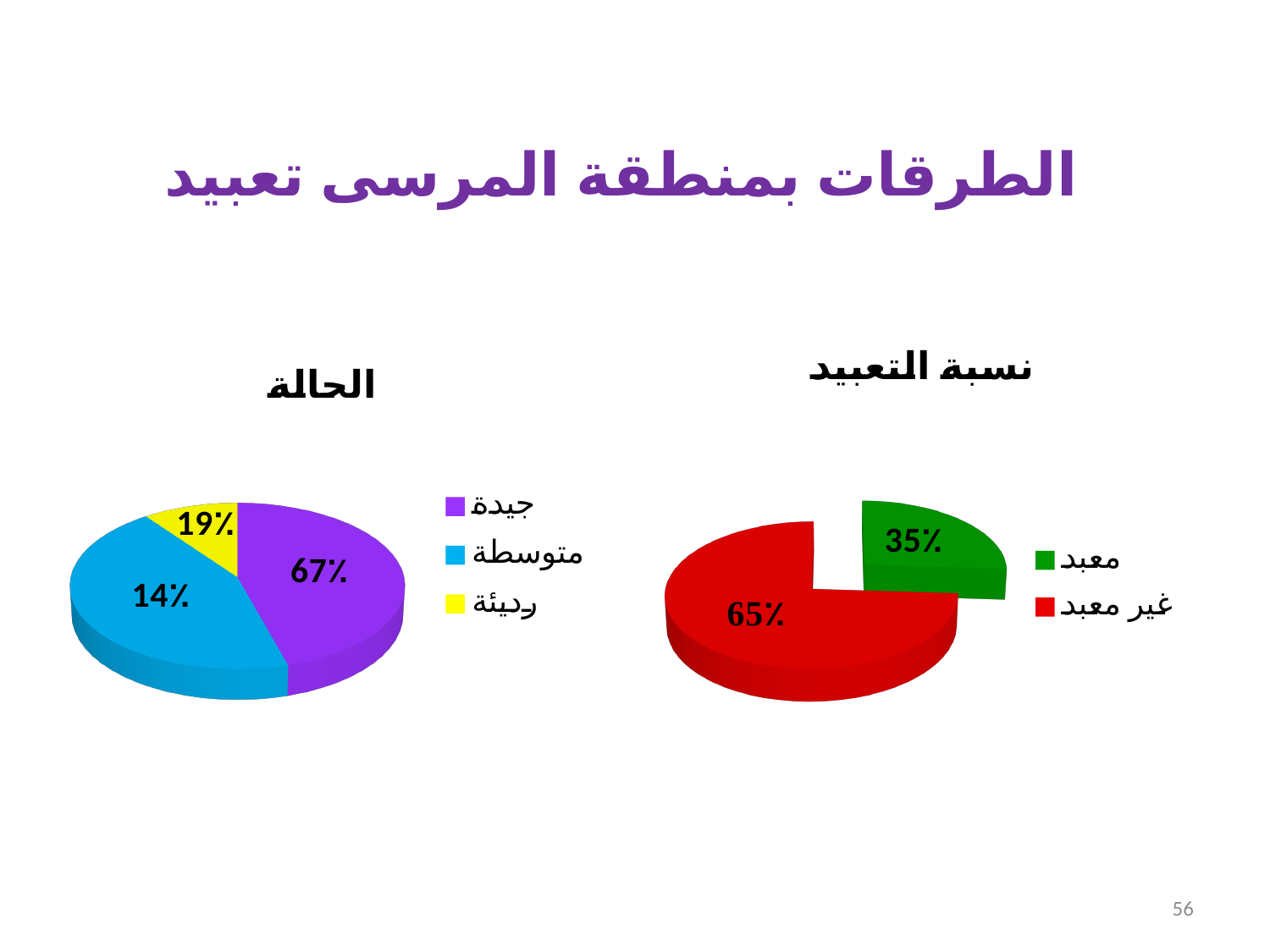
What type of chart is the chart titled "الحالة" (left)? Pie chart In the chart titled "نسبة التعبيد" (right), what percentage is shown for "غير معبد"? 65% In the chart titled "الحالة" (left), what colour represents "جيدة" in the legend? Purple In the chart titled "نسبة التعبيد" (right), what colour represents "غير معبد" in the legend? Red In the chart titled "الحالة" (left), which category has the largest share? جيدة In the chart titled "نسبة التعبيد" (right), which category has the largest share? غير معبد In the chart titled "نسبة التعبيد" (right), how many categories does the legend list? 2 In the chart titled "نسبة التعبيد" (right), what percentage is shown for "معبد"? 35% In the chart titled "الحالة" (left), how many categories does the legend list? 3 In the chart titled "نسبة التعبيد" (right), what is the difference between the "غير معبد" and "معبد" shares? 30% What type of chart is the chart titled "نسبة التعبيد" (right)? Pie chart In the chart titled "الحالة" (left), what percentage is shown for "جيدة"? 67%